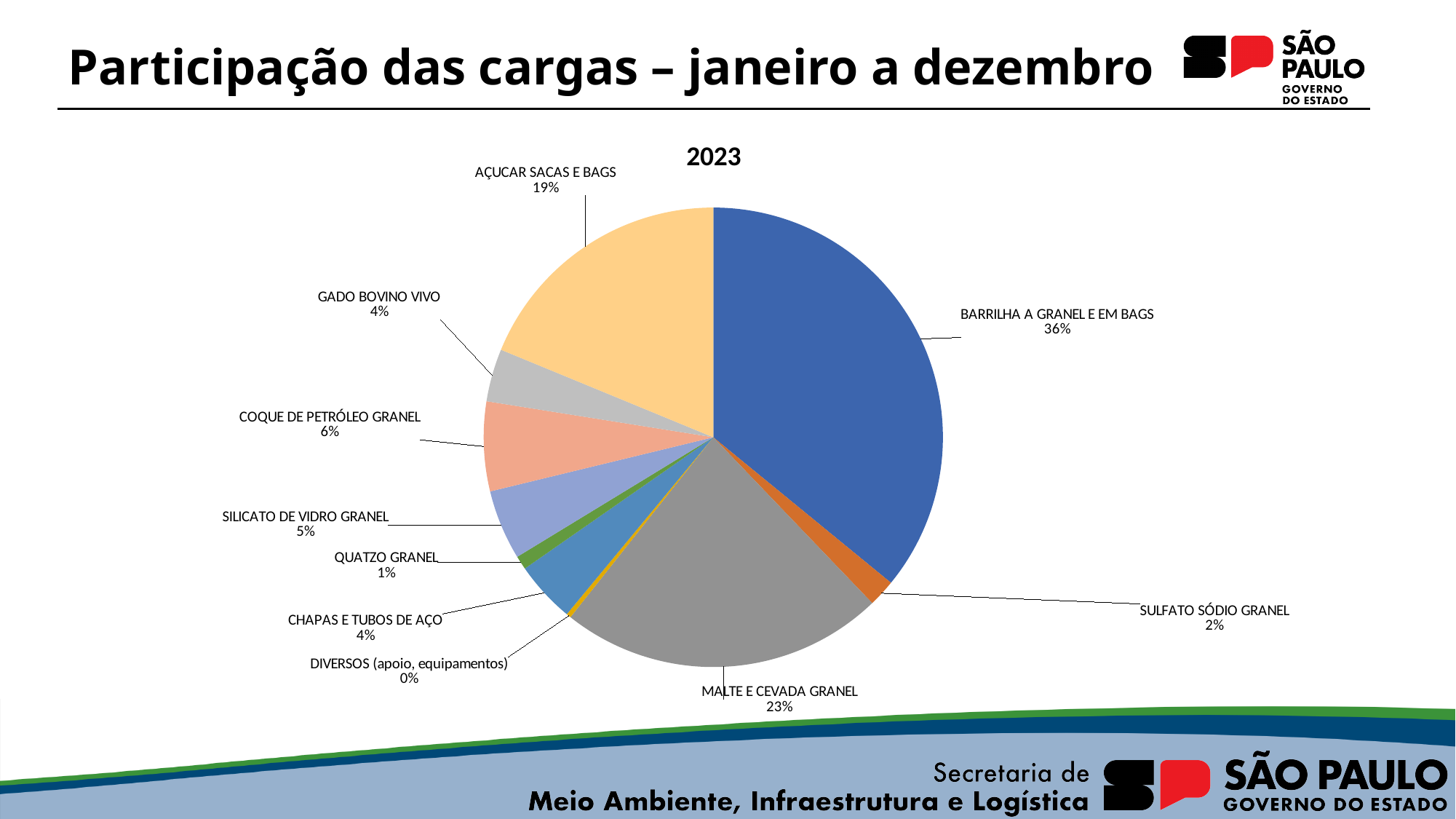
What share of the pie does BARRILHA A GRANEL E EM BAGS represent? 36% What is the title of the chart? 2023 What is the value shown for COQUE DE PETRÓLEO GRANEL? 6% Which category has the smallest share of the pie? DIVERSOS (apoio, equipamentos) Which category has the largest share of the pie? BARRILHA A GRANEL E EM BAGS What kind of chart is shown on the slide? pie chart How many categories are shown in the pie chart? 10 Which is larger, the share of SILICATO DE VIDRO GRANEL or the share of COQUE DE PETRÓLEO GRANEL? COQUE DE PETRÓLEO GRANEL What is the difference between the shares of BARRILHA A GRANEL E EM BAGS and MALTE E CEVADA GRANEL? 13% What is the value shown for AÇUCAR SACAS E BAGS? 19% What is the value shown for MALTE E CEVADA GRANEL? 23% What is the value shown for SULFATO SÓDIO GRANEL? 2%